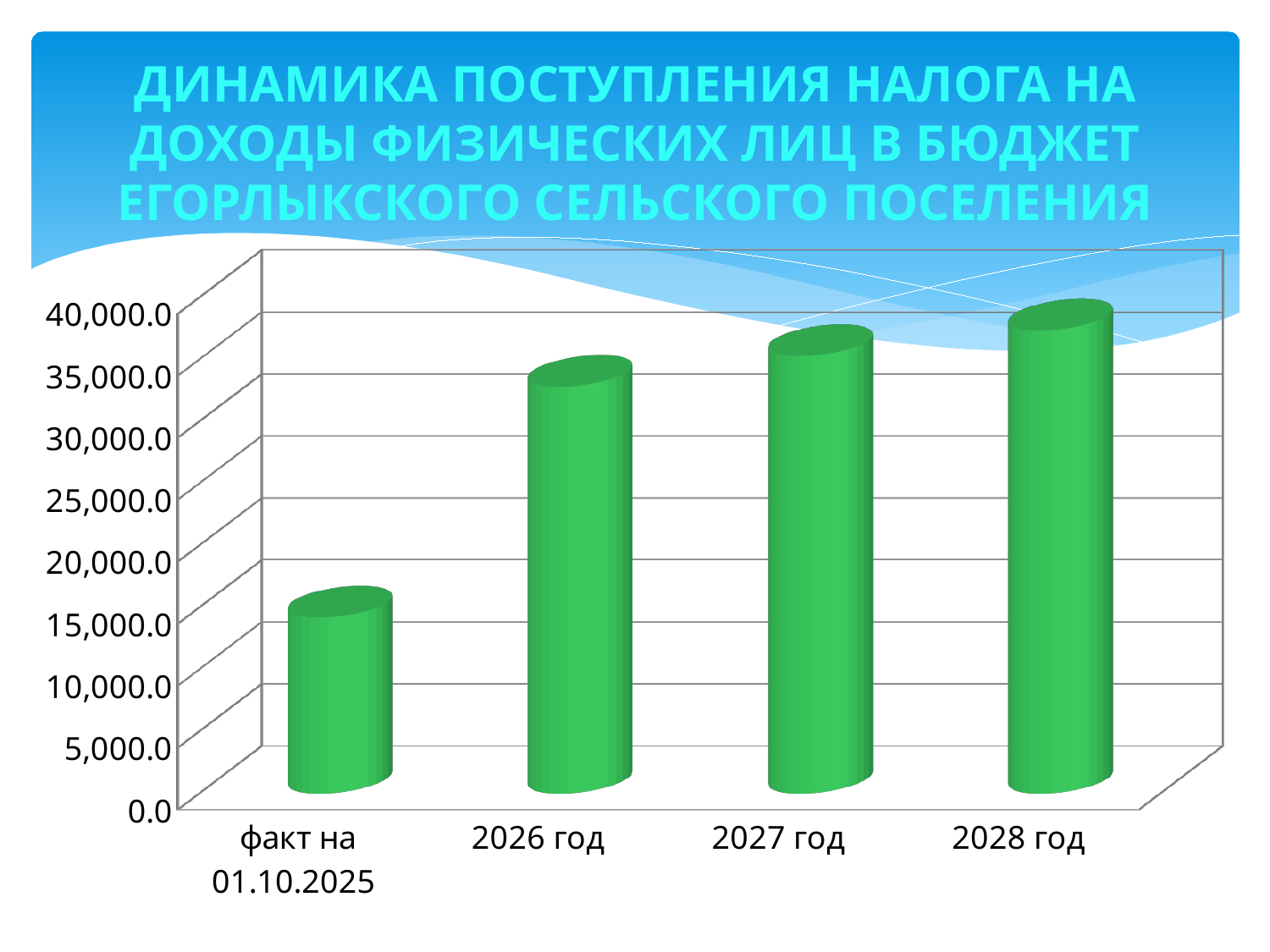
Is the value for факт на 01.10.2025 greater or less than 20,000.0? less What kind of chart is shown on the slide? bar chart Is the value for 2027 год greater or less than 40,000.0? less Do the values rise or fall from left to right along the x axis? rise Is the value for 2026 год greater or less than 30,000.0? greater Which is larger, the value for 2027 год or the value for 2028 год? 2028 год Which category has the lowest value in the chart? факт на 01.10.2025 How many categories are shown on the x axis of the chart? 4 Which is larger, the value for факт на 01.10.2025 or the value for 2026 год? 2026 год Which category has the highest value in the chart? 2028 год What is the title of the slide containing the chart? ДИНАМИКА ПОСТУПЛЕНИЯ НАЛОГА НА ДОХОДЫ ФИЗИЧЕСКИХ ЛИЦ В БЮДЖЕТ ЕГОРЛЫКСКОГО СЕЛЬСКОГО ПОСЕЛЕНИЯ